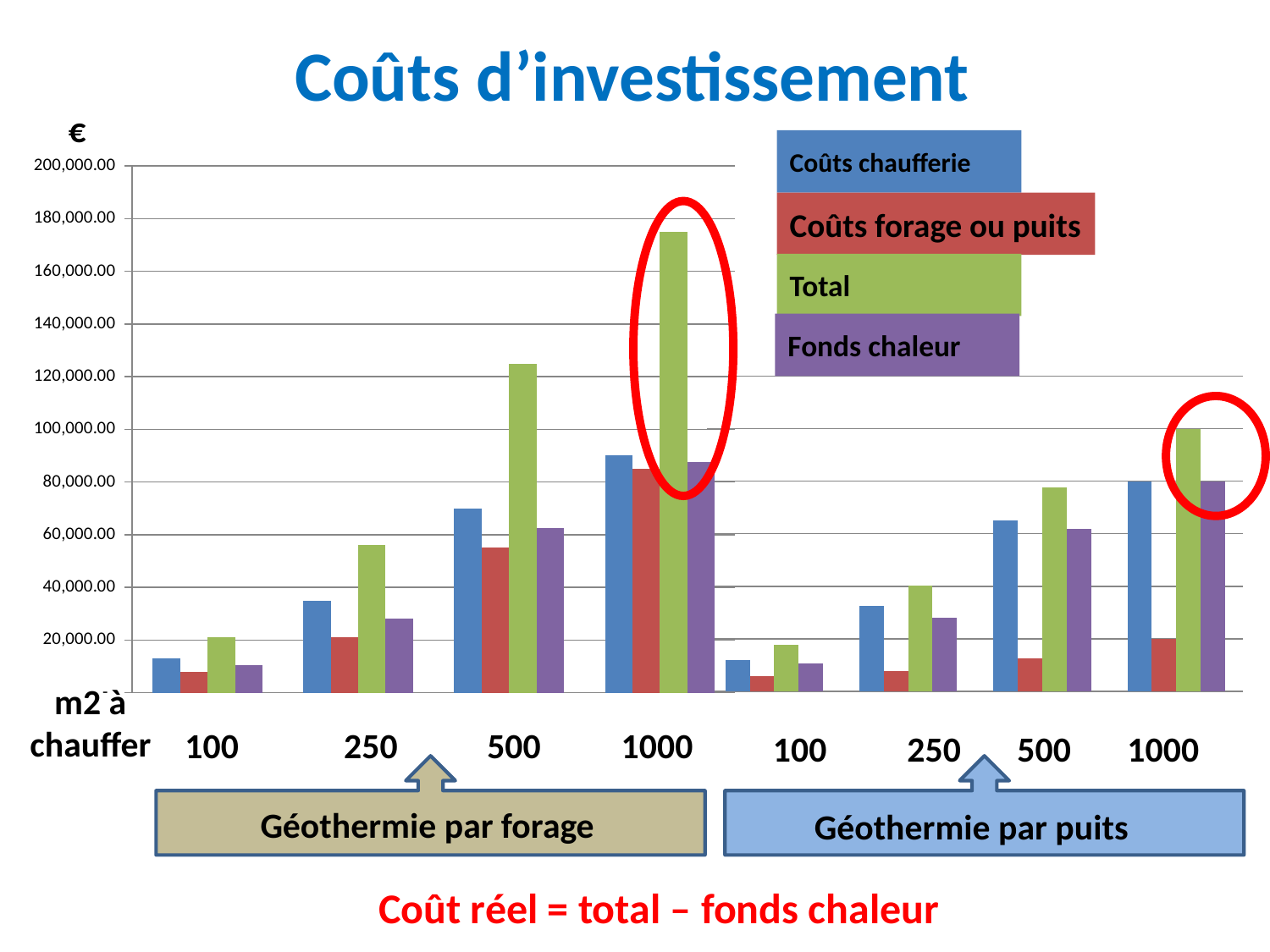
Is the Total value for 500 m2 under Géothermie par forage greater or less than 100,000.00? greater Is the Total value for 1000 m2 under Géothermie par forage greater or less than 160,000.00? greater Which is larger: the Coûts forage ou puits value for 1000 m2 under Géothermie par forage or under Géothermie par puits? Géothermie par forage Within the Géothermie par forage group, do the Total values rise or fall as the m2 à chauffer increases from 100 to 1000? rise Which colour represents the Total series? green How many category groups are plotted along the x axis? 8 How many series does the legend list? 4 Which is larger: the Total for 1000 m2 under Géothermie par forage or the Total for 1000 m2 under Géothermie par puits? Géothermie par forage Is the Coûts chaufferie value for 100 m2 under Géothermie par forage greater or less than 20,000.00? less Which category has the highest Total value? 1000 (Géothermie par forage) What is the title of the chart? Coûts d'investissement What kind of chart is shown on the slide? bar chart